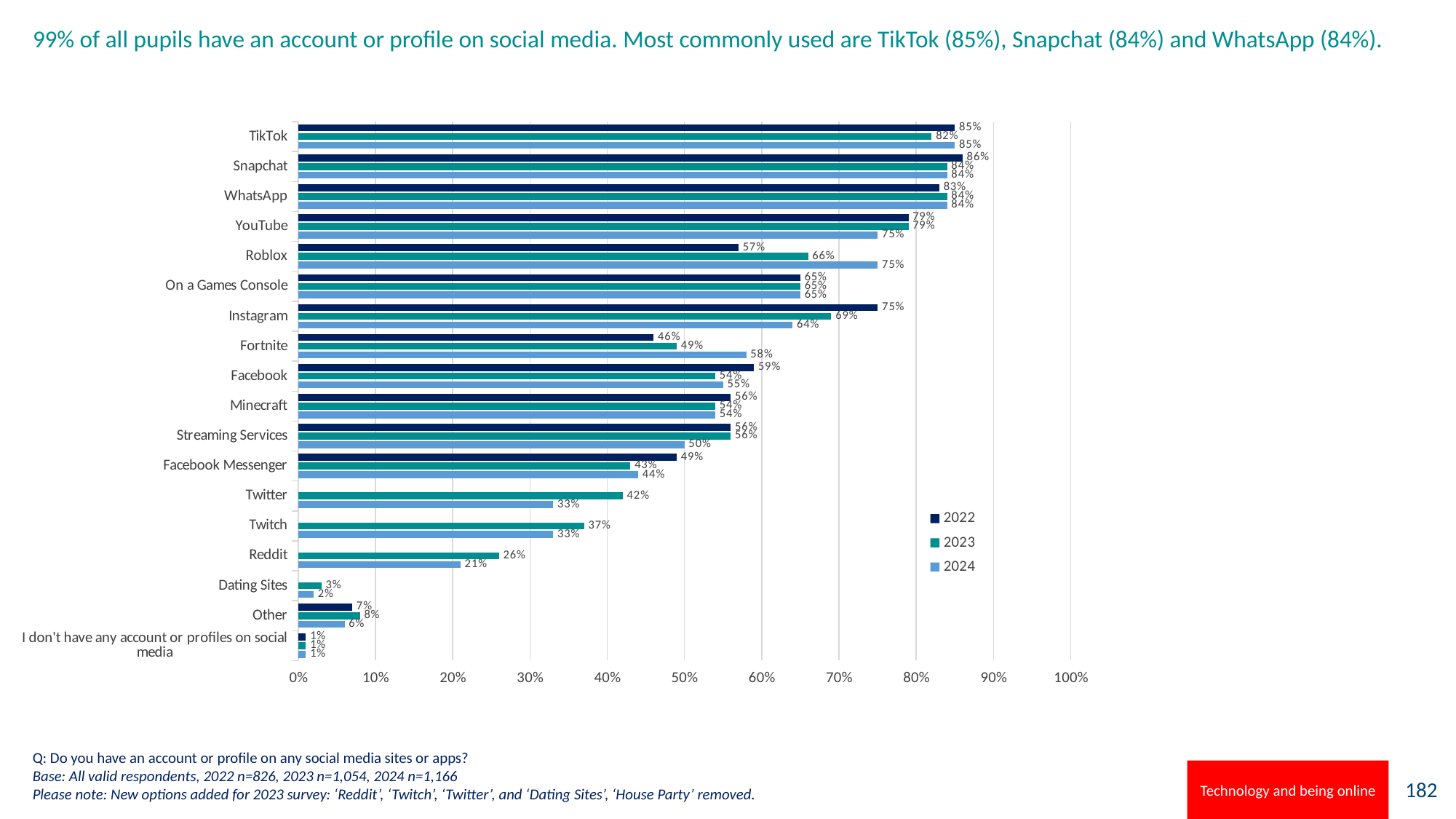
Is the 2024 value for Fortnite greater or less than 50%? greater What is the 2024 value for Roblox? 75% Which category has the highest 2022 value? Snapchat Which category has the lowest 2024 value? I don't have any account or profiles on social media Which series is shown in the darkest colour in the legend? 2022 How does the value for Instagram change from 2022 to 2024? It falls How many series does the legend list? 3 What is the 2022 value for Facebook Messenger? 49% What is the difference between the 2024 and 2022 values for Roblox? 18% What type of chart is shown on the slide? Bar chart What is the 2023 value for Instagram? 69% Which is larger: the 2023 value for Twitter or the 2023 value for Twitch? Twitter